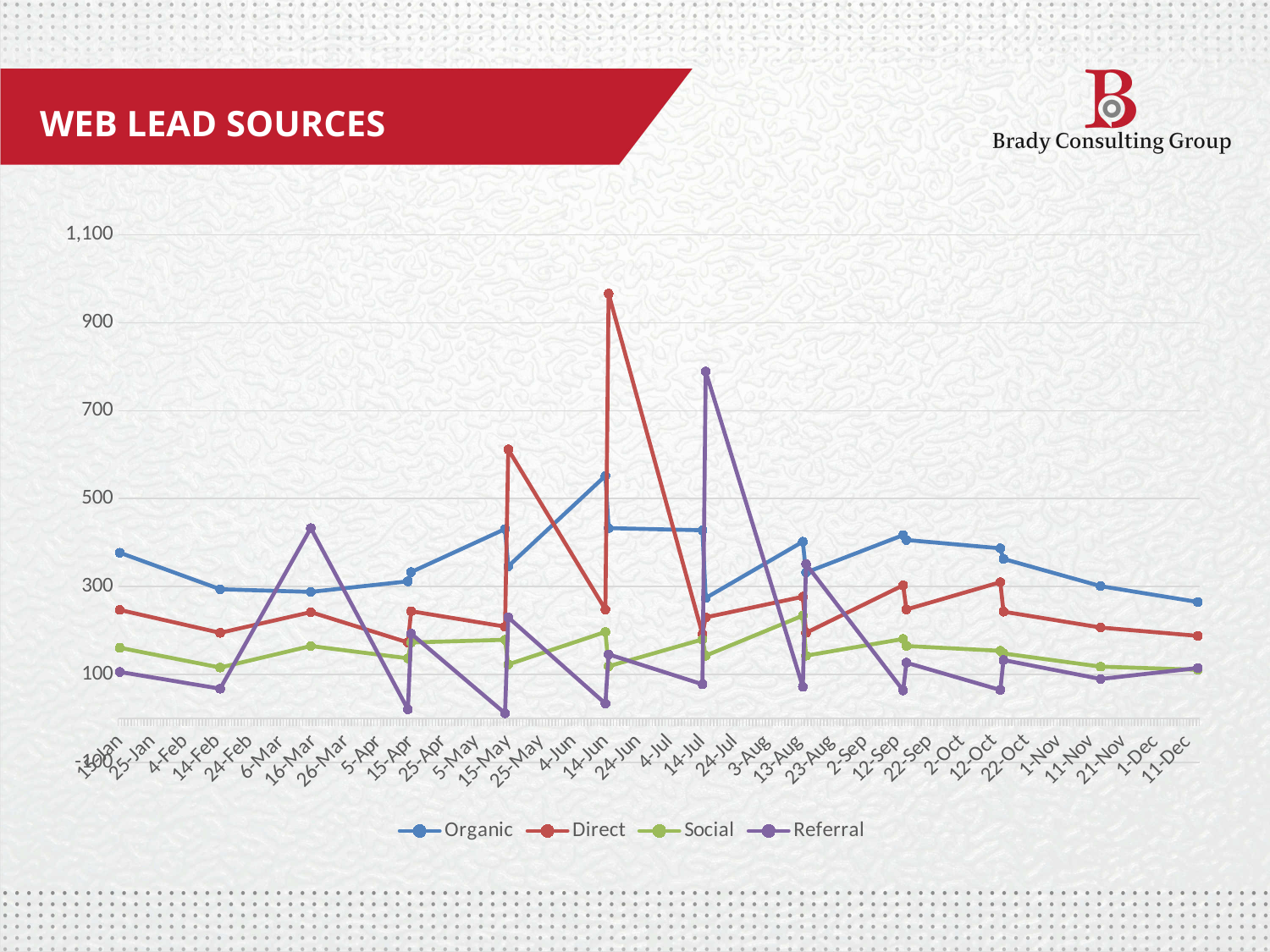
Which series is shown in blue in the legend? Organic Which series reaches the highest value anywhere on the chart? Direct What is the title of the slide containing the chart? WEB LEAD SOURCES Is the peak value of the Referral series greater or less than 700? greater Is the value for Referral at 14-Feb greater or less than 100? less At 16-Mar, which is larger, Referral or Organic? Referral Is the value for Organic at 12-Jan greater or less than 300? greater At 12-Jan, which is larger, Organic or Direct? Organic What kind of chart is shown on the slide? line chart How many series does the legend list? 4 Does the Organic series rise or fall from 22-Sep to 11-Dec? fall